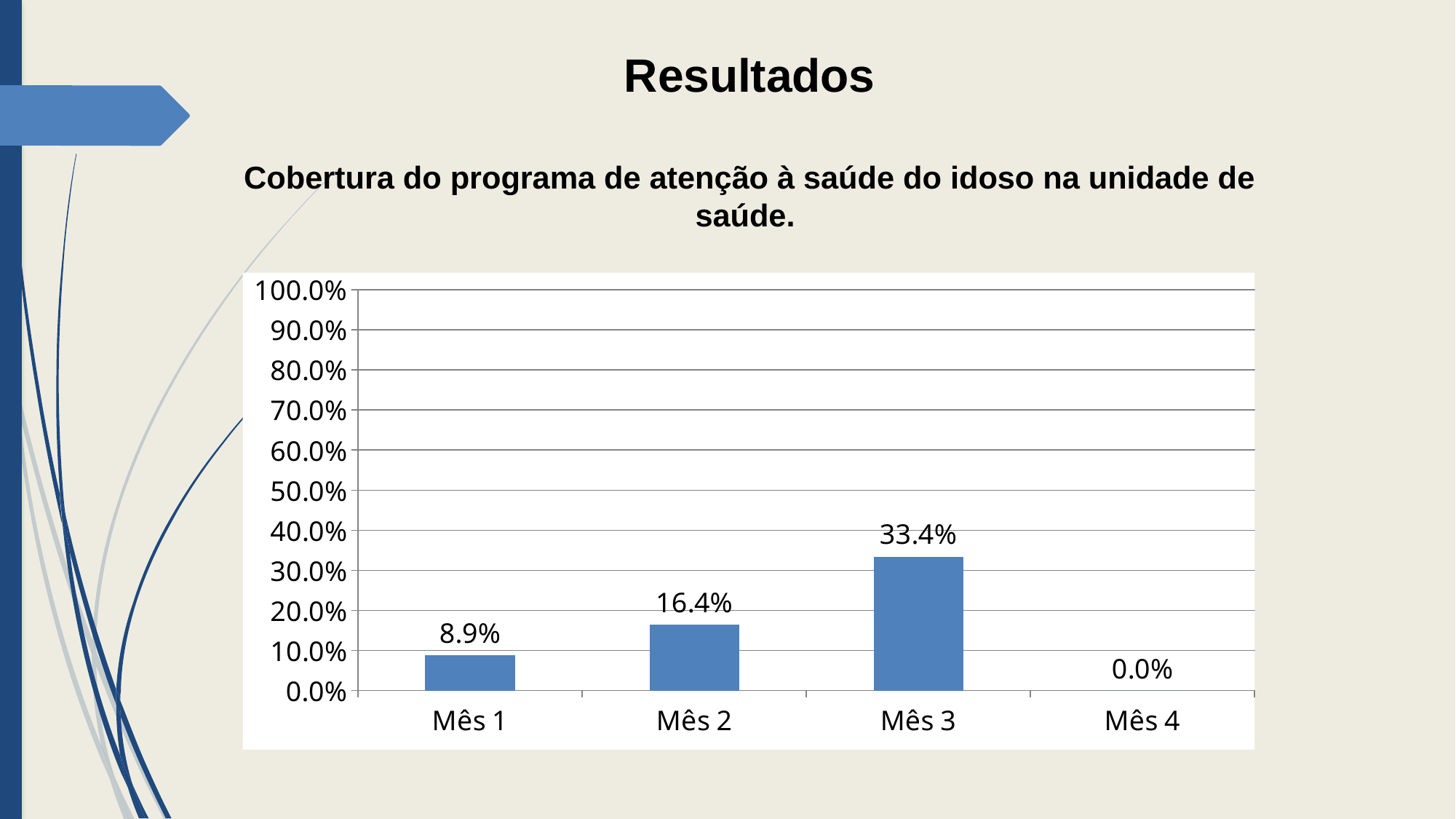
What kind of chart is shown on the slide? Bar chart What is the value for Mês 3? 33.4% Which month has the highest value? Mês 3 What is the value for Mês 4? 0.0% What is the difference between the values for Mês 2 and Mês 1? 7.5% What is the value for Mês 2? 16.4% Which is larger, the value for Mês 1 or the value for Mês 2? Mês 2 What is the value for Mês 1? 8.9% What is the difference between the values for Mês 3 and Mês 2? 17.0% Which month has the lowest value? Mês 4 How many months are shown on the x axis? 4 Is the value for Mês 3 greater or less than 30.0%? greater